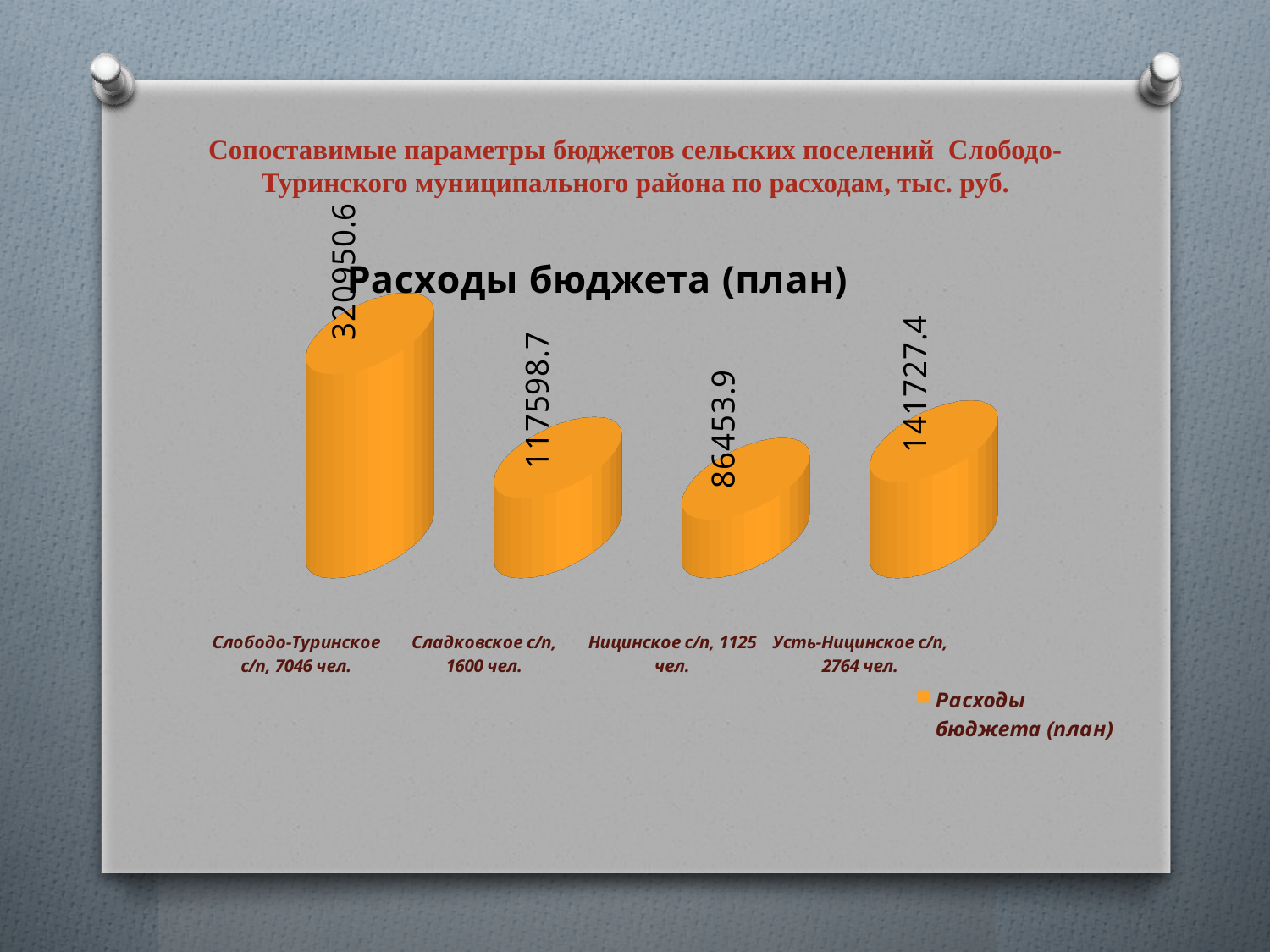
How many categories are shown in the chart? 4 Which category has the lowest value? Ницинское с/п, 1125 чел. What kind of chart is shown on the slide? Bar chart Which category has the highest value? Слободо-Туринское с/п, 7046 чел. How many series does the legend list? 1 What is the difference between the values for Слободо-Туринское с/п and Сладковское с/п? 203351.9 What is the value for Сладковское с/п, 1600 чел.? 117598.7 What is the difference between the values for Усть-Ницинское с/п and Ницинское с/п? 55273.5 What is the value for Ницинское с/п, 1125 чел.? 86453.9 What is the value for Усть-Ницинское с/п, 2764 чел.? 141727.4 Which is larger, the value for Сладковское с/п or the value for Усть-Ницинское с/п? Усть-Ницинское с/п What is the value for Слободо-Туринское с/п, 7046 чел.? 320950.6